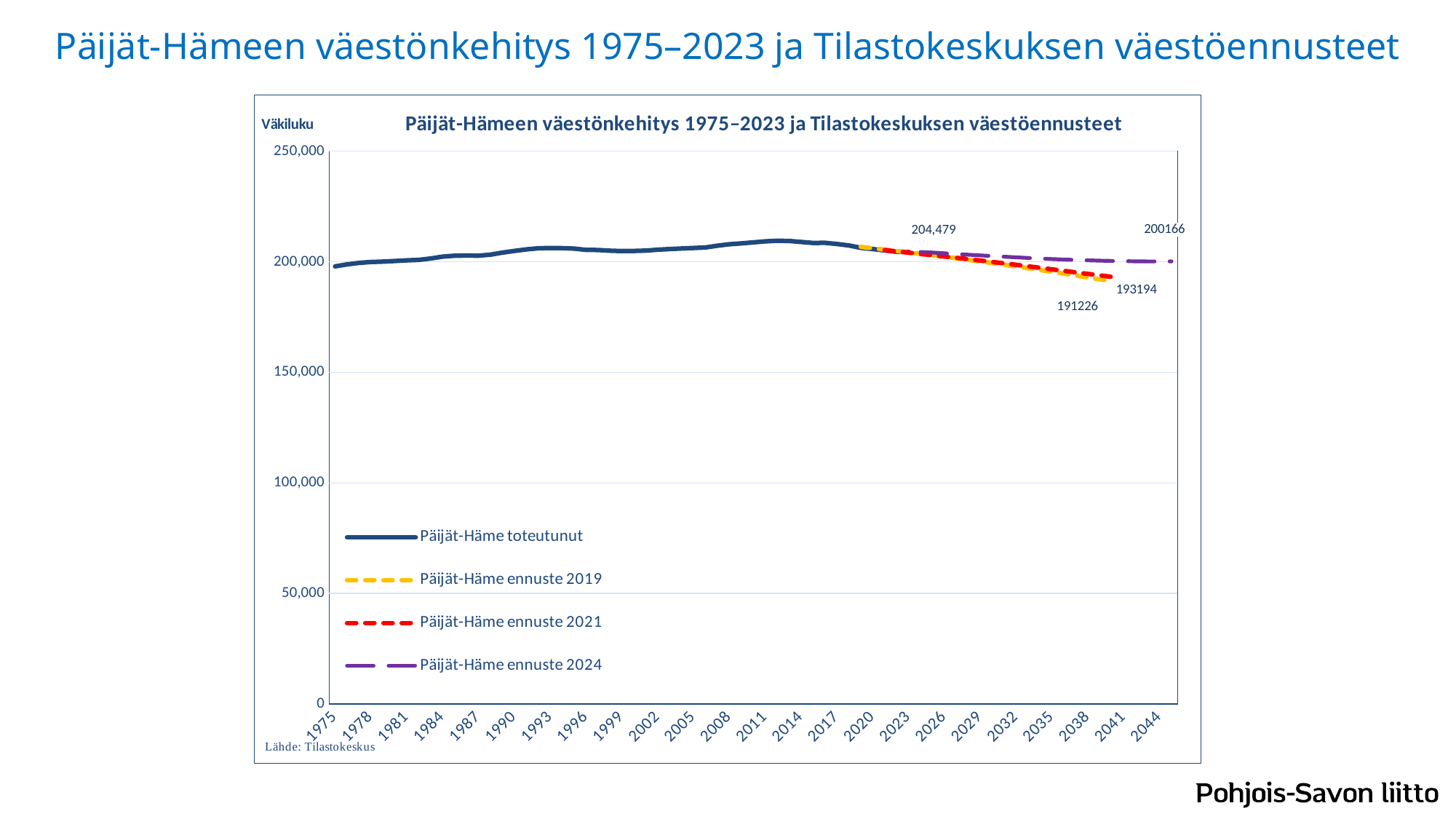
What is the difference between the end value of the ennuste 2024 line (200166) and the end value of the ennuste 2019 line (191226)? 8940 How many series does the legend list? 4 What is the title of the chart? Päijät-Hämeen väestönkehitys 1975–2023 ja Tilastokeskuksen väestöennusteet What value is labelled at the end of the Päijät-Häme ennuste 2019 line? 191226 Do the forecast lines rise or fall from 2023 onwards? fall Which forecast line ends at the highest value: ennuste 2019, ennuste 2021 or ennuste 2024? Päijät-Häme ennuste 2024 What value is labelled at the end of the Päijät-Häme toteutunut line? 204,479 What kind of chart is shown on the slide? line chart Is the value of the Päijät-Häme toteutunut line in 1975 greater or less than 150,000? greater What value is labelled at the end of the Päijät-Häme ennuste 2024 line? 200166 Which forecast line ends at the lowest value: ennuste 2019, ennuste 2021 or ennuste 2024? Päijät-Häme ennuste 2019 What value is labelled at the end of the Päijät-Häme ennuste 2021 line? 193194